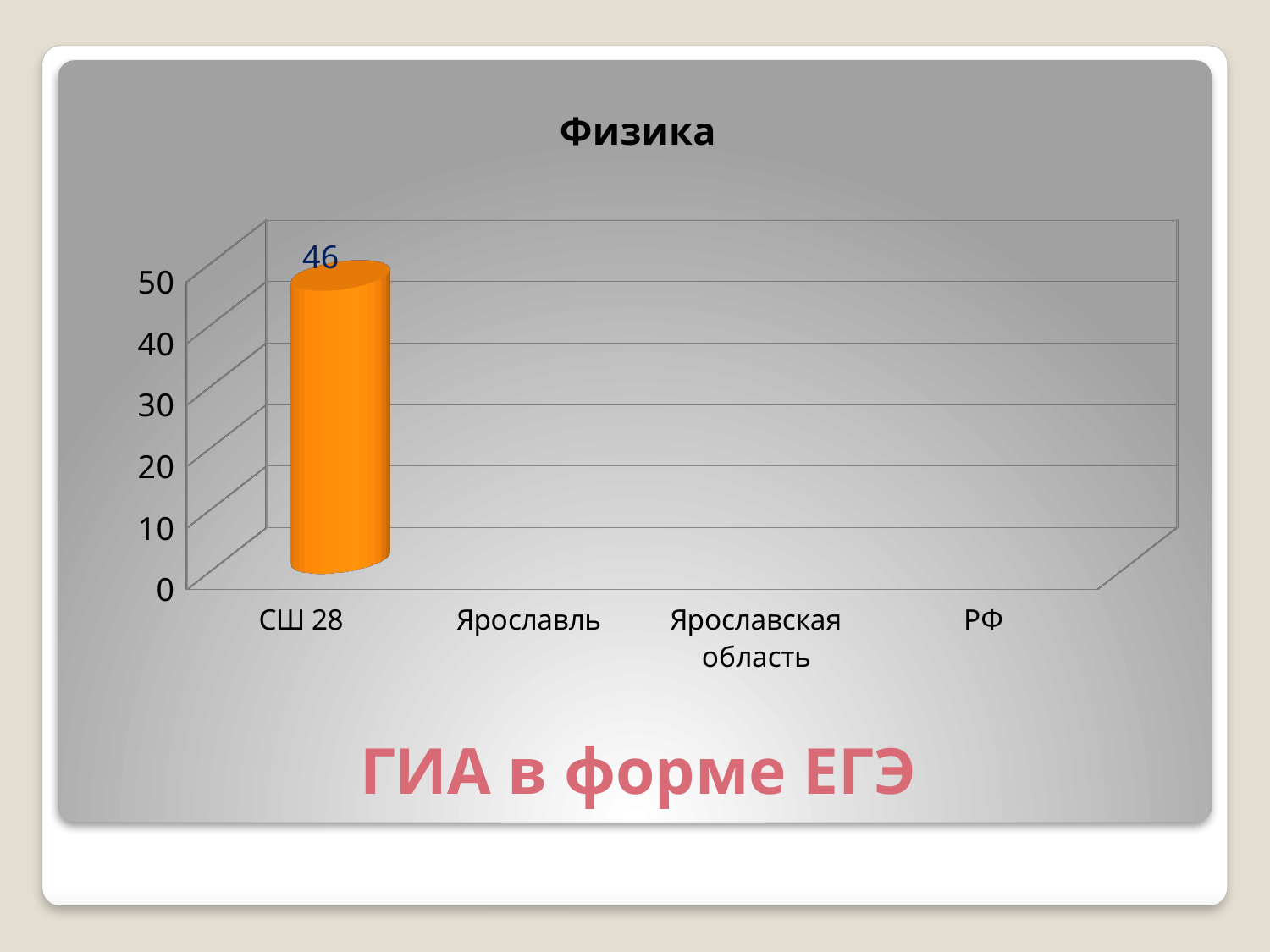
How many categories are shown on the x axis of the chart? 4 Is the value for СШ 28 greater or less than 40? greater Is the value for СШ 28 greater or less than 50? less What kind of chart is shown on the slide? bar chart What is the highest tick value shown on the vertical axis? 50 Which category has the highest value in the chart? СШ 28 What is the title of the chart? Физика Which categories on the x axis have no bar plotted? Ярославль, Ярославская область, РФ What is the value for СШ 28 in the Физика chart? 46 What colour is the bar for СШ 28? orange